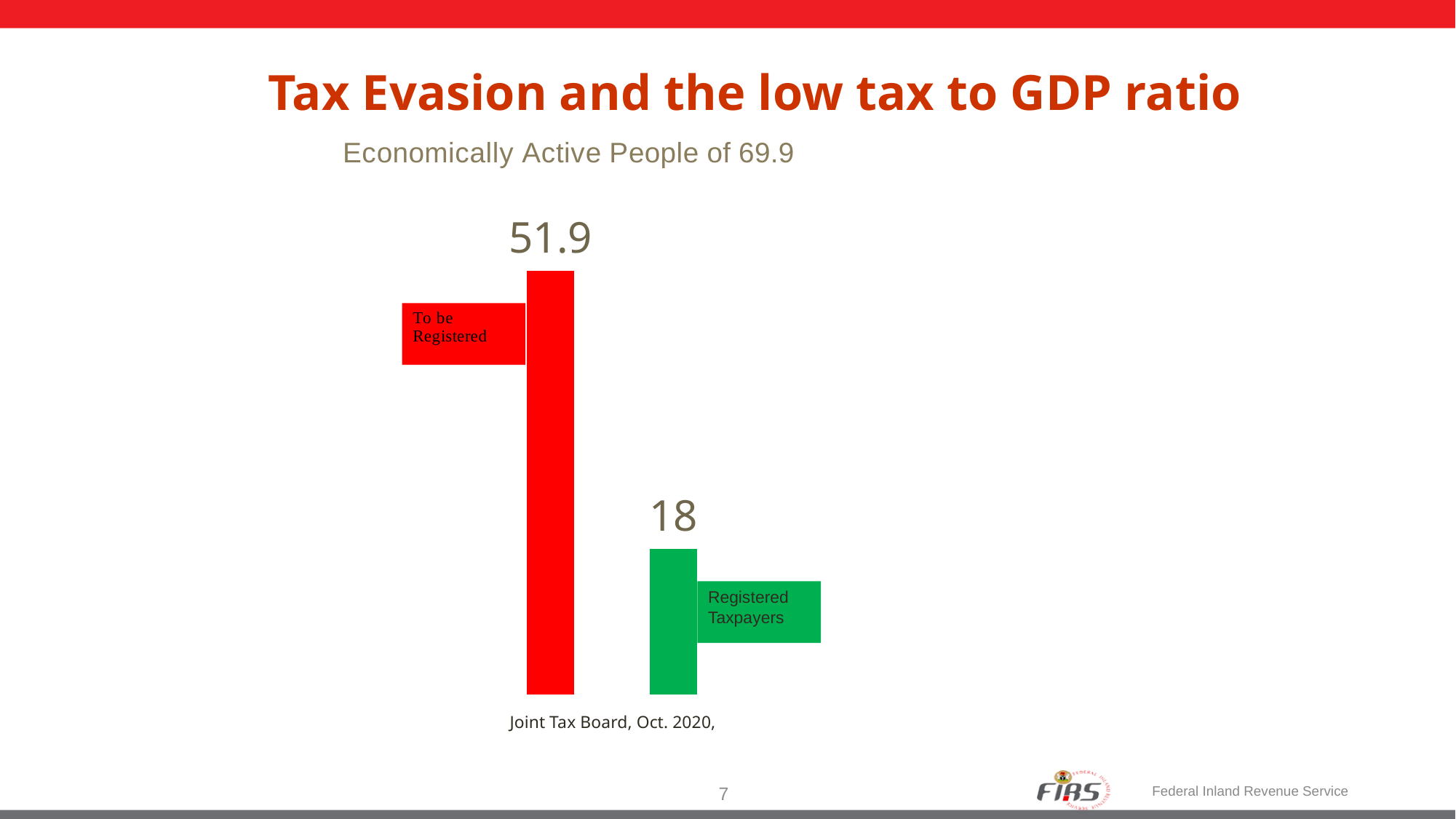
Which category has the lowest value in the chart? Registered Taxpayers Is the value for Registered Taxpayers larger or smaller than the value for To be Registered? smaller What is the title of the chart? Economically Active People of 69.9 What colour is the bar for Registered Taxpayers? green What is the difference between the To be Registered value and the Registered Taxpayers value? 33.9 Which category has the higher value, To be Registered or Registered Taxpayers? To be Registered What is the value shown for Registered Taxpayers? 18 What is the total of the two bar values in the chart? 69.9 What kind of chart is shown on the slide? bar chart What is the value shown for To be Registered? 51.9 How many bars are plotted in the chart? 2